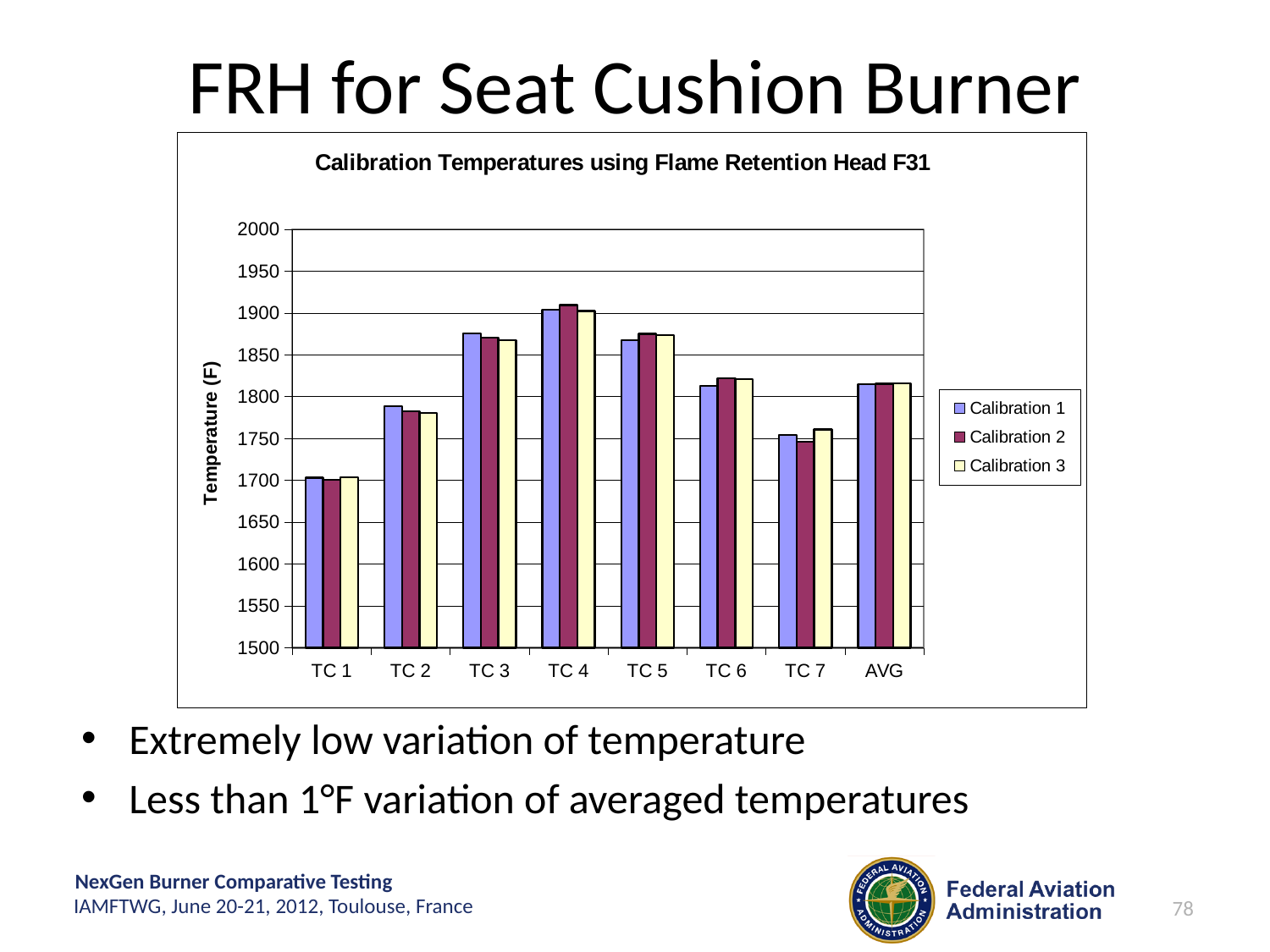
Is the value for TC 3 in Calibration 1 greater or less than 1850? greater What is the title of the chart? Calibration Temperatures using Flame Retention Head F31 What kind of chart is shown on the slide? bar chart For Calibration 1, which is larger: the value for TC 2 or the value for TC 6? TC 6 How many categories are shown on the x axis? 8 Which category has the highest temperature for Calibration 1? TC 4 For Calibration 3, do the values rise or fall from TC 1 to TC 4? rise Is the value for TC 4 in Calibration 2 greater or less than 1900? greater How many series does the legend list? 3 Is the value for TC 2 in Calibration 1 greater or less than 1800? less Which category has the lowest temperature for Calibration 2? TC 1